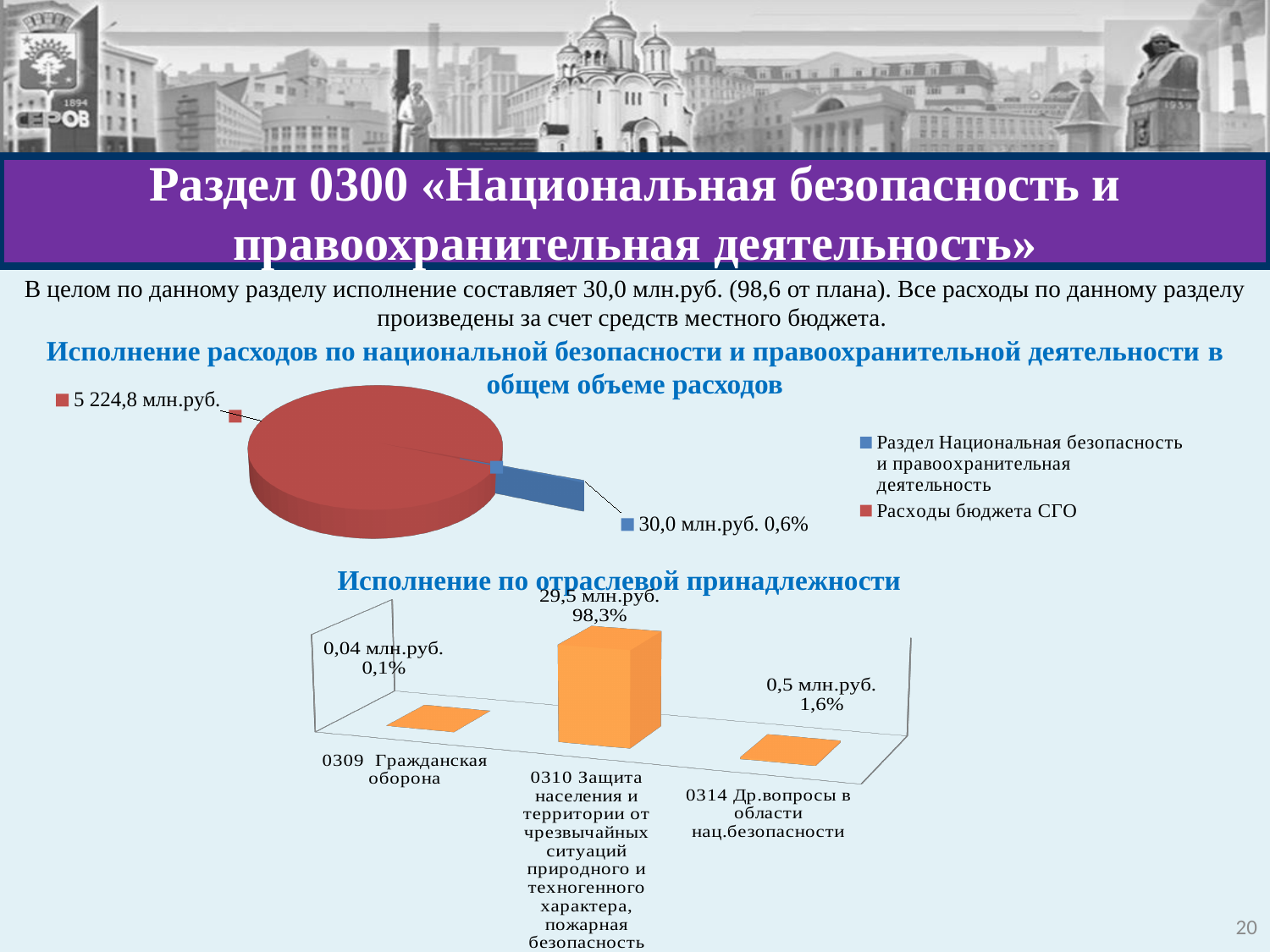
On the chart titled «Исполнение по отраслевой принадлежности», what is the value for «0309 Гражданская оборона»? 0,04 млн.руб. What kind of chart is the one titled «Исполнение по отраслевой принадлежности»? Bar chart How many entries does the legend of the pie chart at the top of the slide list? 2 On the chart titled «Исполнение по отраслевой принадлежности», what is the value for «0310 Защита населения и территории от чрезвычайных ситуаций природного и техногенного характера, пожарная безопасность»? 29,5 млн.руб. What kind of chart is the one titled «Исполнение расходов по национальной безопасности и правоохранительной деятельности в общем объеме расходов»? Pie chart On the chart titled «Исполнение по отраслевой принадлежности», which is larger: the value for «0314 Др.вопросы в области нац.безопасности» or for «0309 Гражданская оборона»? 0314 Др.вопросы в области нац.безопасности On the chart titled «Исполнение по отраслевой принадлежности», how many categories are shown? 3 On the chart titled «Исполнение по отраслевой принадлежности», which category has the highest value? 0310 Защита населения и территории от чрезвычайных ситуаций природного и техногенного характера, пожарная безопасность On the pie chart at the top of the slide, what share does «Раздел Национальная безопасность и правоохранительная деятельность» have? 0,6% On the chart titled «Исполнение по отраслевой принадлежности», which category has the lowest value? 0309 Гражданская оборона On the chart titled «Исполнение по отраслевой принадлежности», what percentage is shown for «0314 Др.вопросы в области нац.безопасности»? 1,6% On the pie chart at the top of the slide, what value is shown for «Расходы бюджета СГО»? 5 224,8 млн.руб.